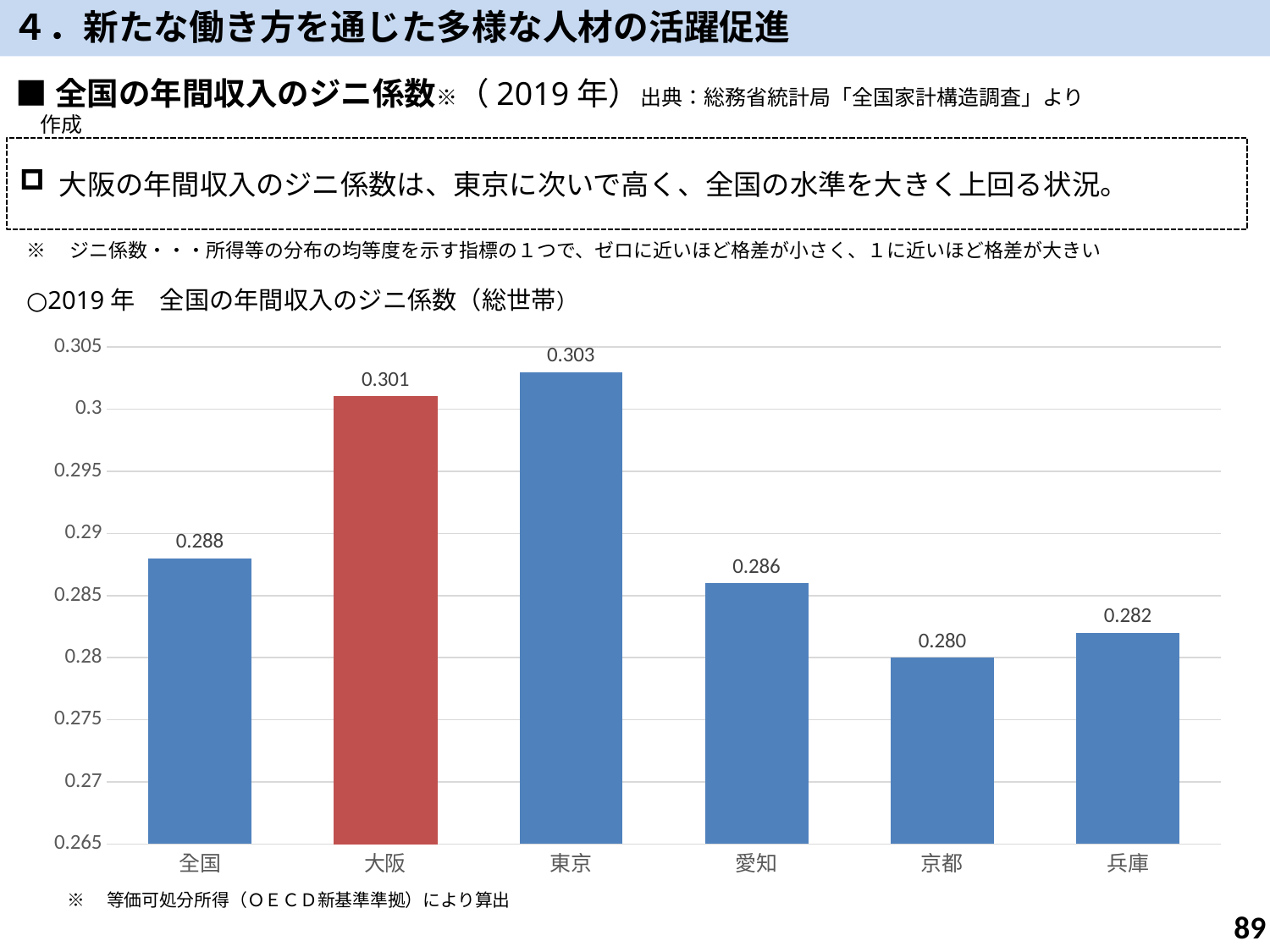
What is the Gini coefficient value shown for 全国? 0.288 What is the difference between the Gini coefficient for 東京 and for 大阪? 0.002 How many categories are shown on the x axis of the chart? 6 Which category has the highest Gini coefficient in the chart? 東京 What is the difference between the Gini coefficient for 大阪 and for 全国? 0.013 Which category has the lowest Gini coefficient in the chart? 京都 What kind of chart is shown on the slide? bar chart Which has a larger Gini coefficient, 愛知 or 兵庫? 愛知 Which bar in the chart is coloured red rather than blue? 大阪 What is the Gini coefficient value shown for 大阪? 0.301 What is the Gini coefficient value shown for 京都? 0.280 Is the value for 兵庫 greater or less than 0.285? less